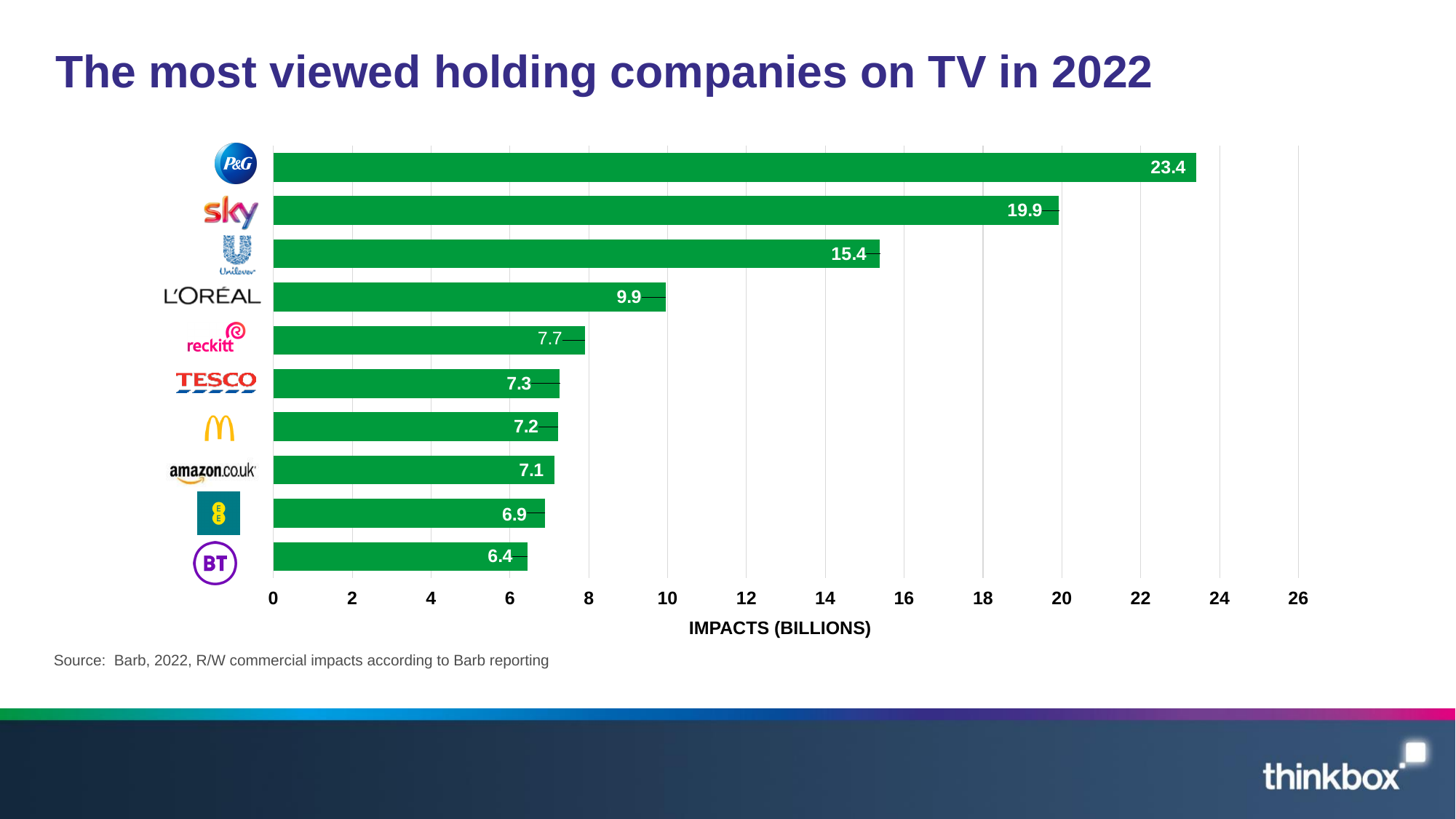
What is the value for L'Oréal? 9.9 What is the value for P&G? 23.4 What is the difference between the values for P&G and Sky? 3.5 Which has a larger value, Reckitt or Tesco? Reckitt What is the difference between the values for Unilever and L'Oréal? 5.5 What is the value for Sky? 19.9 What is the value for BT? 6.4 Which company has the highest value? P&G What kind of chart is this? Bar chart Which company has the lowest value? BT What is the label of the horizontal axis? IMPACTS (BILLIONS) How many companies are shown in the chart? 10